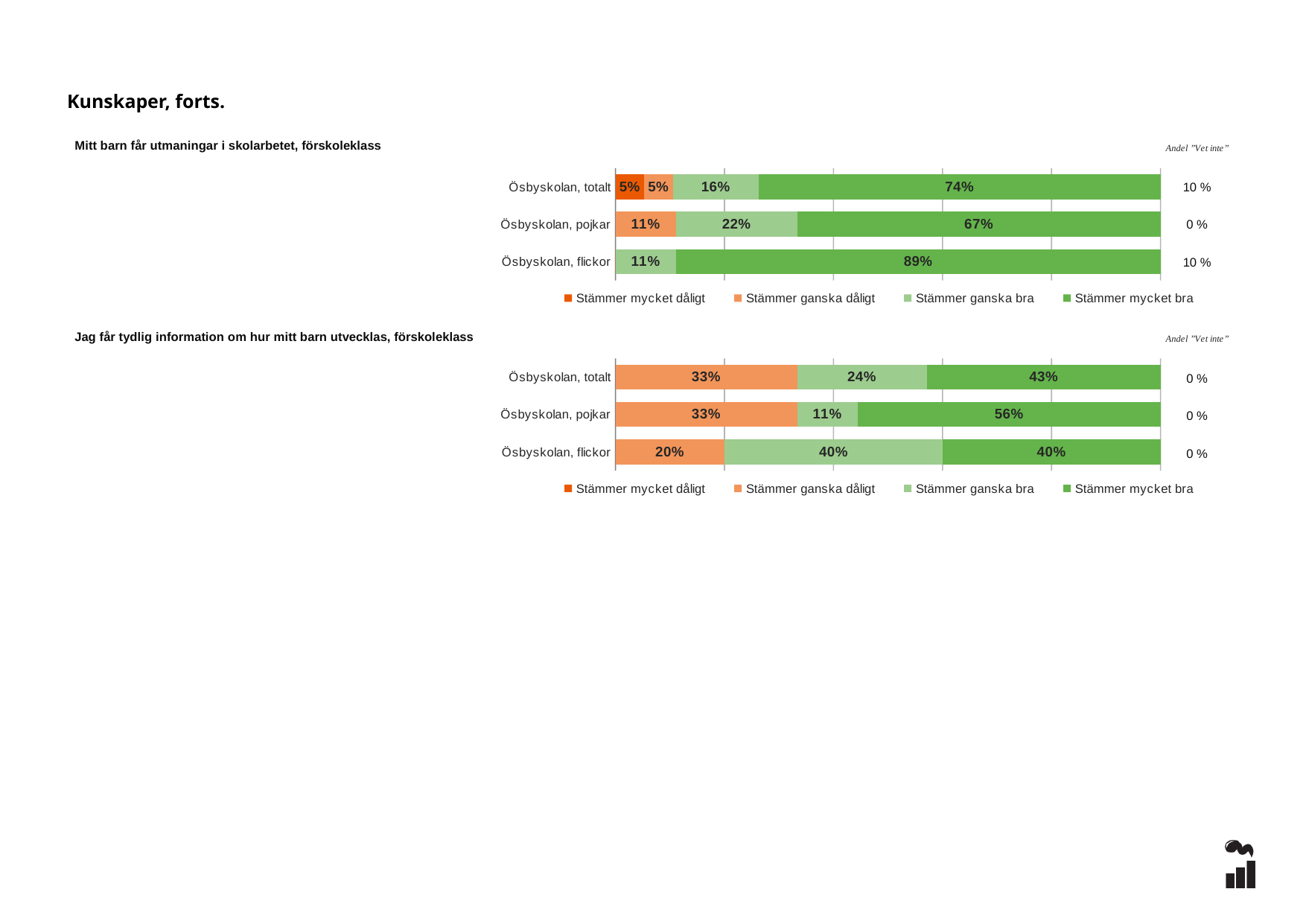
In the chart "Mitt barn får utmaningar i skolarbetet, förskoleklass", what is the difference between the "Stämmer mycket bra" values for Ösbyskolan, flickor and Ösbyskolan, pojkar? 22% In the chart "Jag får tydlig information om hur mitt barn utvecklas, förskoleklass", what is the value of "Stämmer mycket bra" for Ösbyskolan, pojkar? 56% In the chart "Mitt barn får utmaningar i skolarbetet, förskoleklass", what is the value of "Stämmer ganska bra" for Ösbyskolan, pojkar? 22% In the chart "Jag får tydlig information om hur mitt barn utvecklas, förskoleklass", what is the total of the "Stämmer ganska bra" and "Stämmer mycket bra" segments for Ösbyskolan, flickor? 80% How many series does the legend of the chart "Mitt barn får utmaningar i skolarbetet, förskoleklass" list? 4 In the chart "Jag får tydlig information om hur mitt barn utvecklas, förskoleklass", which category has the lowest value for "Stämmer ganska bra"? Ösbyskolan, pojkar What kind of chart is "Jag får tydlig information om hur mitt barn utvecklas, förskoleklass"? Stacked bar chart In the chart "Jag får tydlig information om hur mitt barn utvecklas, förskoleklass", what is the value of "Stämmer ganska dåligt" for Ösbyskolan, flickor? 20% In the chart "Mitt barn får utmaningar i skolarbetet, förskoleklass", which category has the highest value for "Stämmer mycket bra"? Ösbyskolan, flickor In the chart "Jag får tydlig information om hur mitt barn utvecklas, förskoleklass", which is larger for Ösbyskolan, totalt: "Stämmer ganska dåligt" or "Stämmer mycket bra"? Stämmer mycket bra In the chart "Mitt barn får utmaningar i skolarbetet, förskoleklass", what is the "Andel Vet inte" value for Ösbyskolan, totalt? 10 % In the chart "Mitt barn får utmaningar i skolarbetet, förskoleklass", what is the value of "Stämmer mycket bra" for Ösbyskolan, flickor? 89%